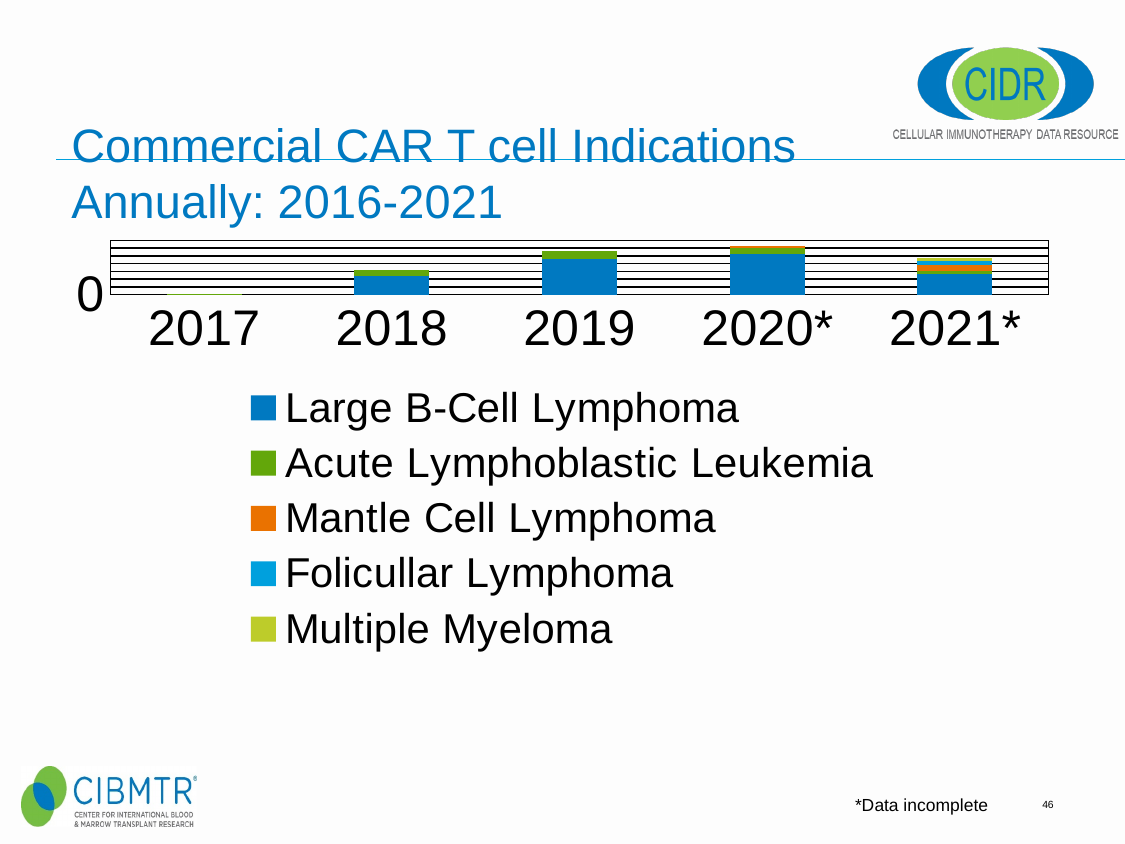
Which years are marked with an asterisk indicating incomplete data? 2020* and 2021* How many series does the chart's legend list? 5 Which year has the smallest bar in the chart? 2017 What is the title of the chart on the slide? Commercial CAR T cell Indications Annually: 2016-2021 Which bar is taller, 2018 or 2019? 2019 Do the bar totals rise or fall from 2017 to 2020*? Rise Which series makes up the largest part of the 2020* bar? Large B-Cell Lymphoma Which series is shown in dark blue in the legend? Large B-Cell Lymphoma How many years are shown on the x axis of the chart? 5 Which bar is taller, 2020* or 2021*? 2020* Which year has the tallest bar in the chart? 2020* What kind of chart is shown on the slide? Stacked bar chart